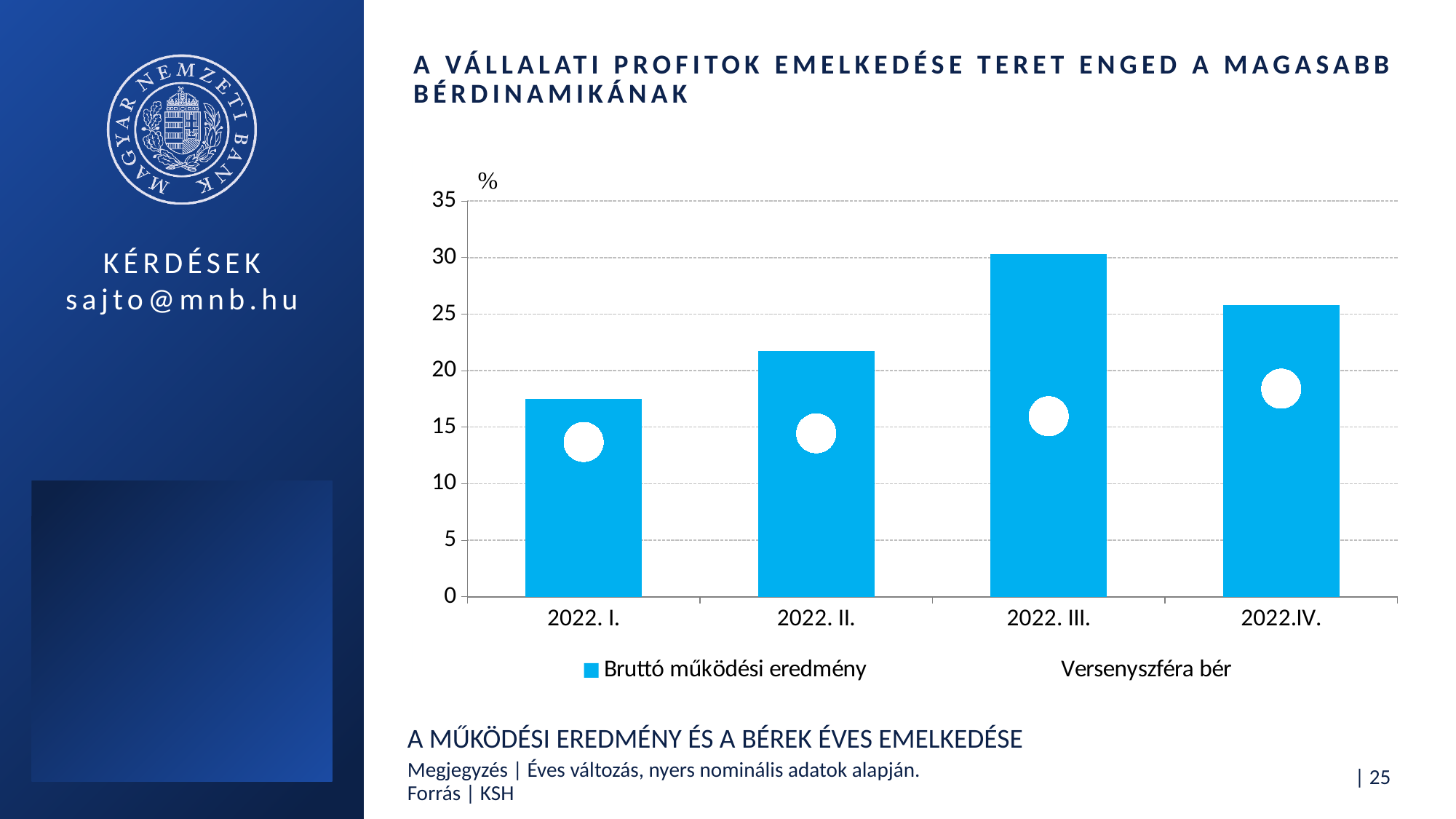
How many quarters are shown on the x axis of the chart? 4 What unit is shown at the top of the vertical axis of the chart? % Do the Versenyszféra bér markers rise or fall from 2022. I. to 2022.IV.? rise How many series does the chart legend list? 2 What kind of chart is shown on the slide? bar chart with a line/marker series Is the Bruttó működési eredmény bar for 2022. I. greater or less than 20? less Which quarter has the lowest bar for Bruttó működési eredmény? 2022. I. Which is larger, the Bruttó működési eredmény bar for 2022. II. or for 2022.IV.? 2022.IV. Is the Bruttó működési eredmény bar for 2022. II. greater or less than 20? greater Which quarter has the highest bar for Bruttó működési eredmény? 2022. III. Which quarter has the highest Versenyszféra bér marker? 2022.IV. Is the Bruttó működési eredmény bar for 2022. III. greater or less than 25? greater